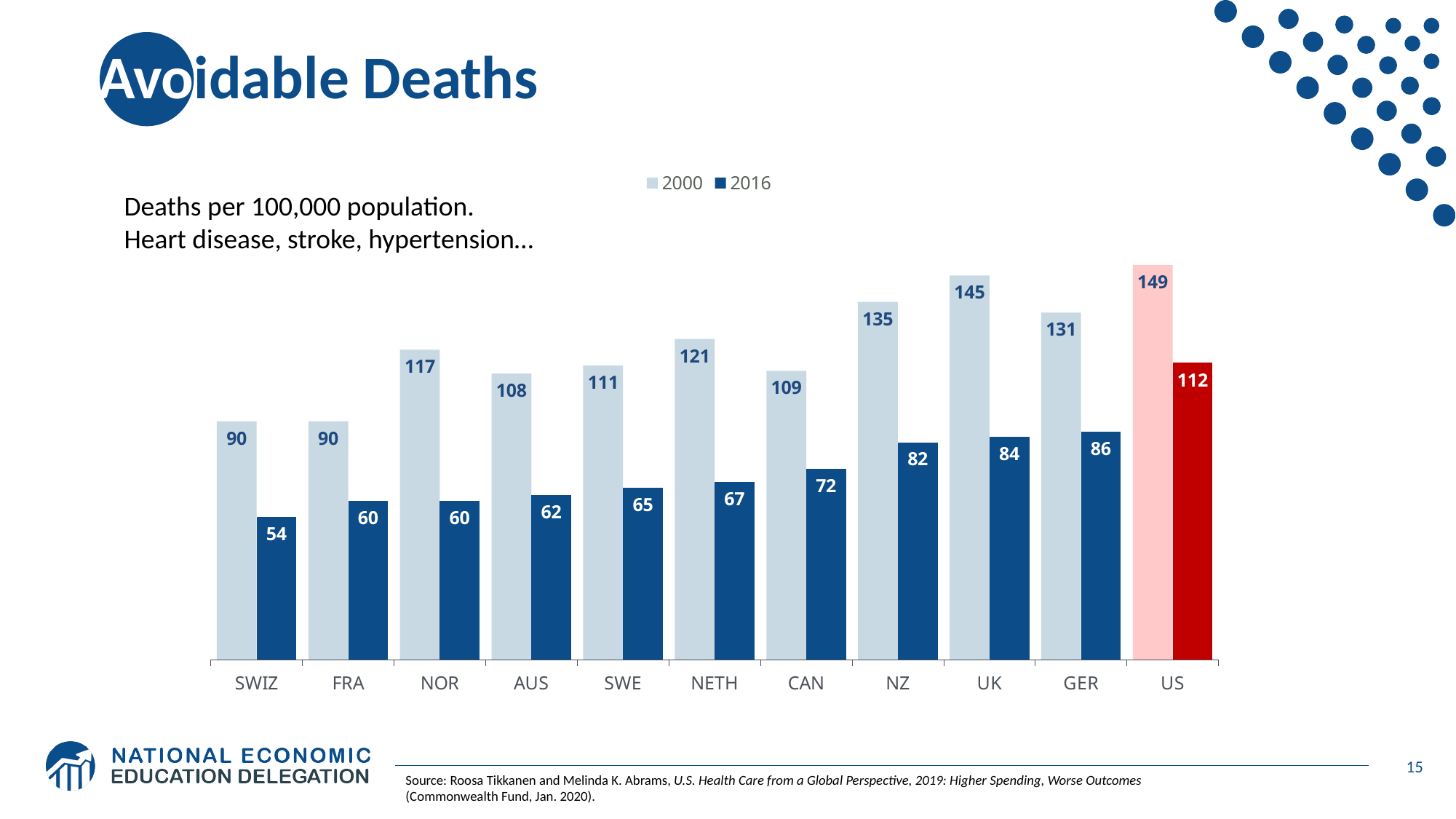
What was the value for the US in 2000? 149 What is the difference between the US values for 2000 and 2016? 37 What is the difference between the 2016 values for GER and FRA? 26 What kind of chart is shown on the slide? Bar chart Which country had the highest value in 2016? US Which is larger, the 2000 value for UK or the 2000 value for NZ? UK Which country had the lowest value in 2016? SWIZ What was the value for NETH in 2000? 121 Which country's bars are highlighted in red? US How many countries are shown on the x axis? 11 What was the value for SWIZ in 2016? 54 How many series does the legend list? 2